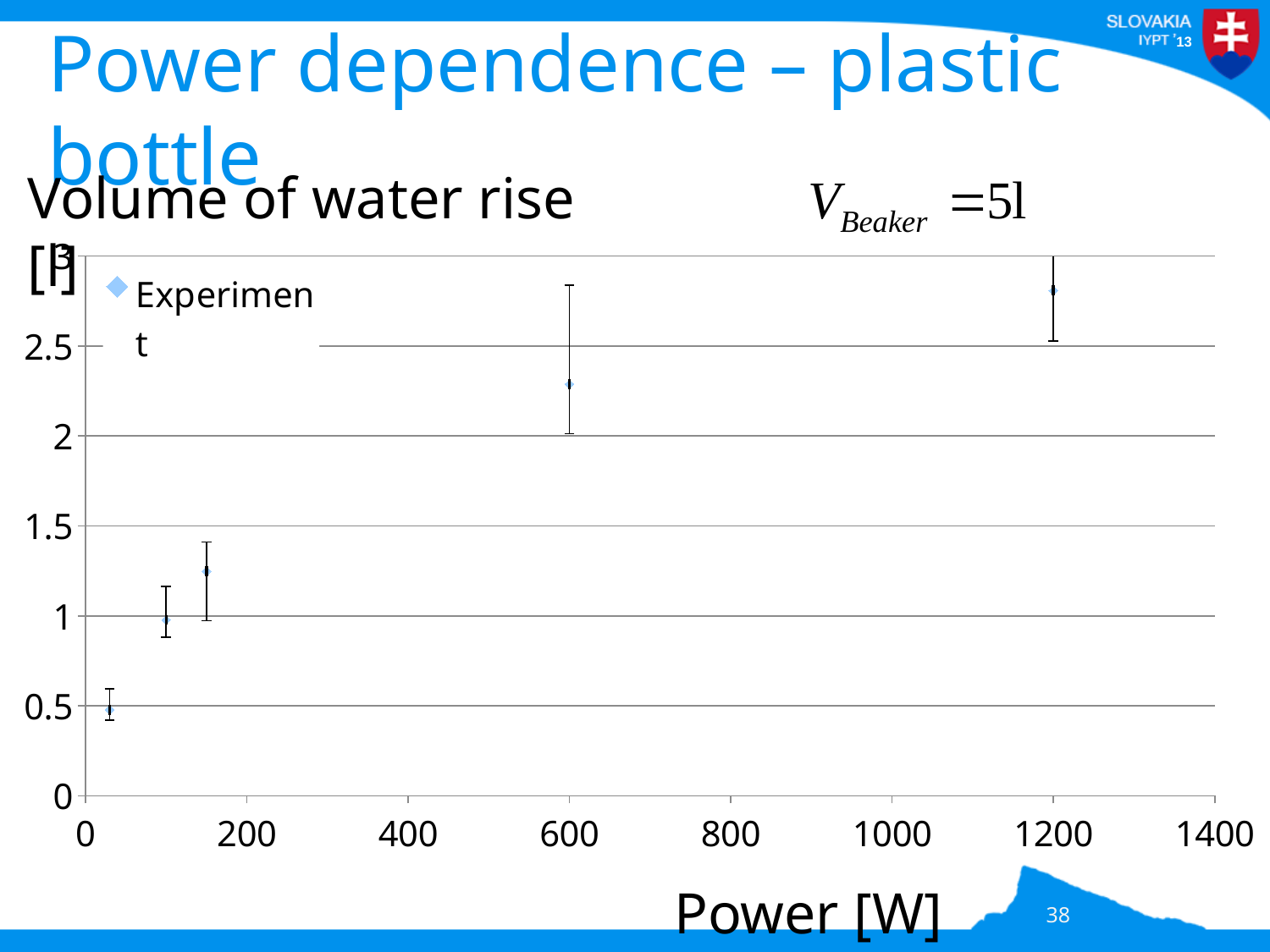
Is the volume of water rise for the data point at 1200 W greater or less than 2.5? greater Which data point has the highest volume of water rise, the one at 600 W or the one at 1200 W? 1200 W What is the label of the x axis? Power [W] What is the name of the series shown in the legend? Experiment What kind of chart is shown on the slide? scatter chart Is the volume of water rise for the data point at 600 W greater or less than 2? greater How many data points are plotted in the chart? 5 At which power value is the volume of water rise the highest? 1200 W How many series does the legend list? 1 Is the volume of water rise for the data point at about 150 W greater or less than 1.5? less Do the plotted values rise or fall as power increases along the x axis? rise